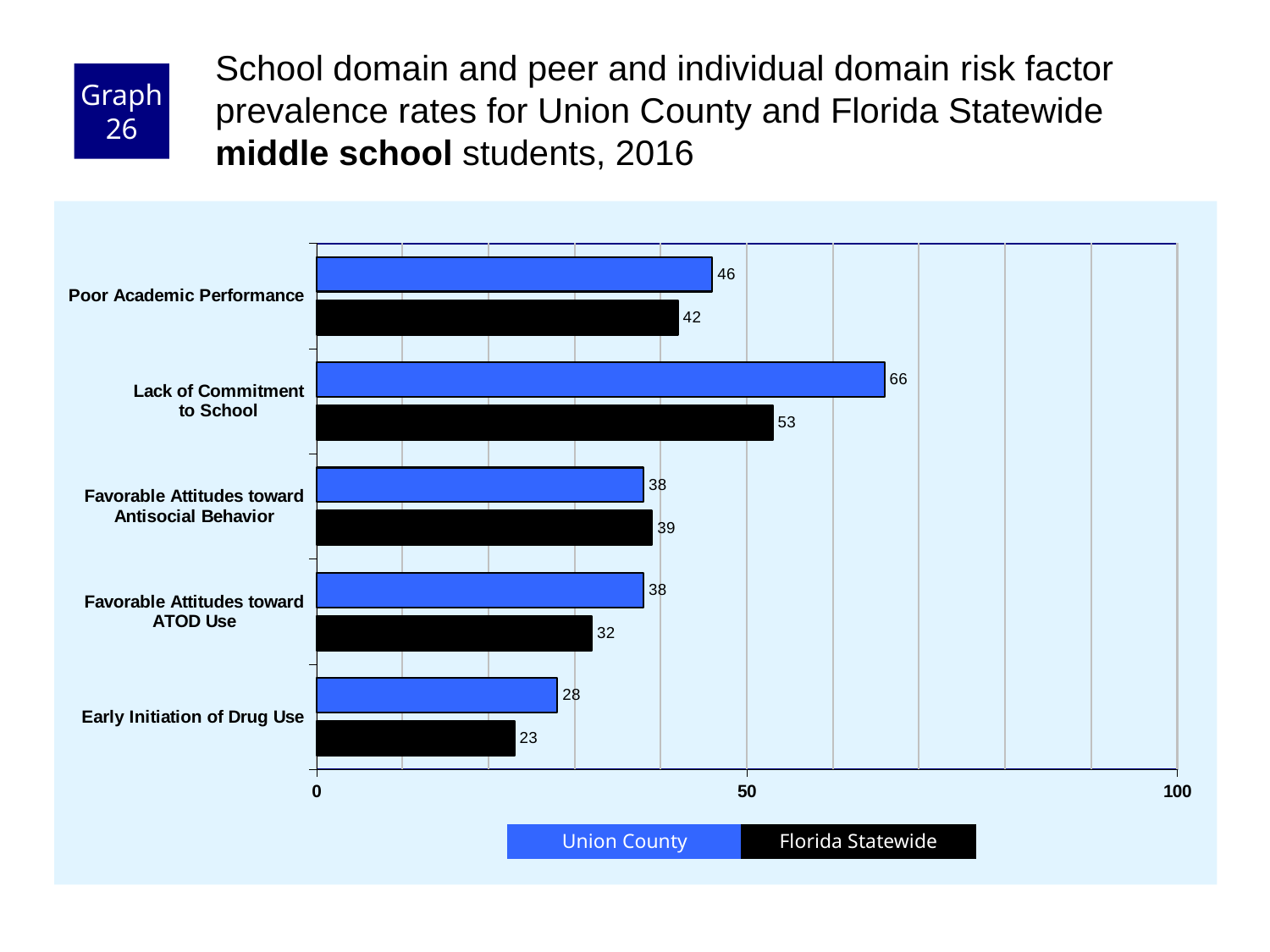
Which risk factor has the lowest Florida Statewide value? Early Initiation of Drug Use What is the Union County value for Lack of Commitment to School? 66 Is the Union County value for Poor Academic Performance greater or less than 50? less How many risk factor categories are shown on the chart? 5 For Favorable Attitudes toward Antisocial Behavior, which is larger: the Union County value or the Florida Statewide value? Florida Statewide What is the difference between the Union County and Florida Statewide values for Poor Academic Performance? 4 What is the Florida Statewide value for Early Initiation of Drug Use? 23 What is the difference between the Union County and Florida Statewide values for Lack of Commitment to School? 13 Which risk factor has the highest Union County value? Lack of Commitment to School What kind of chart is shown on the slide? bar chart How many series does the legend list? 2 What is the Florida Statewide value for Favorable Attitudes toward ATOD Use? 32